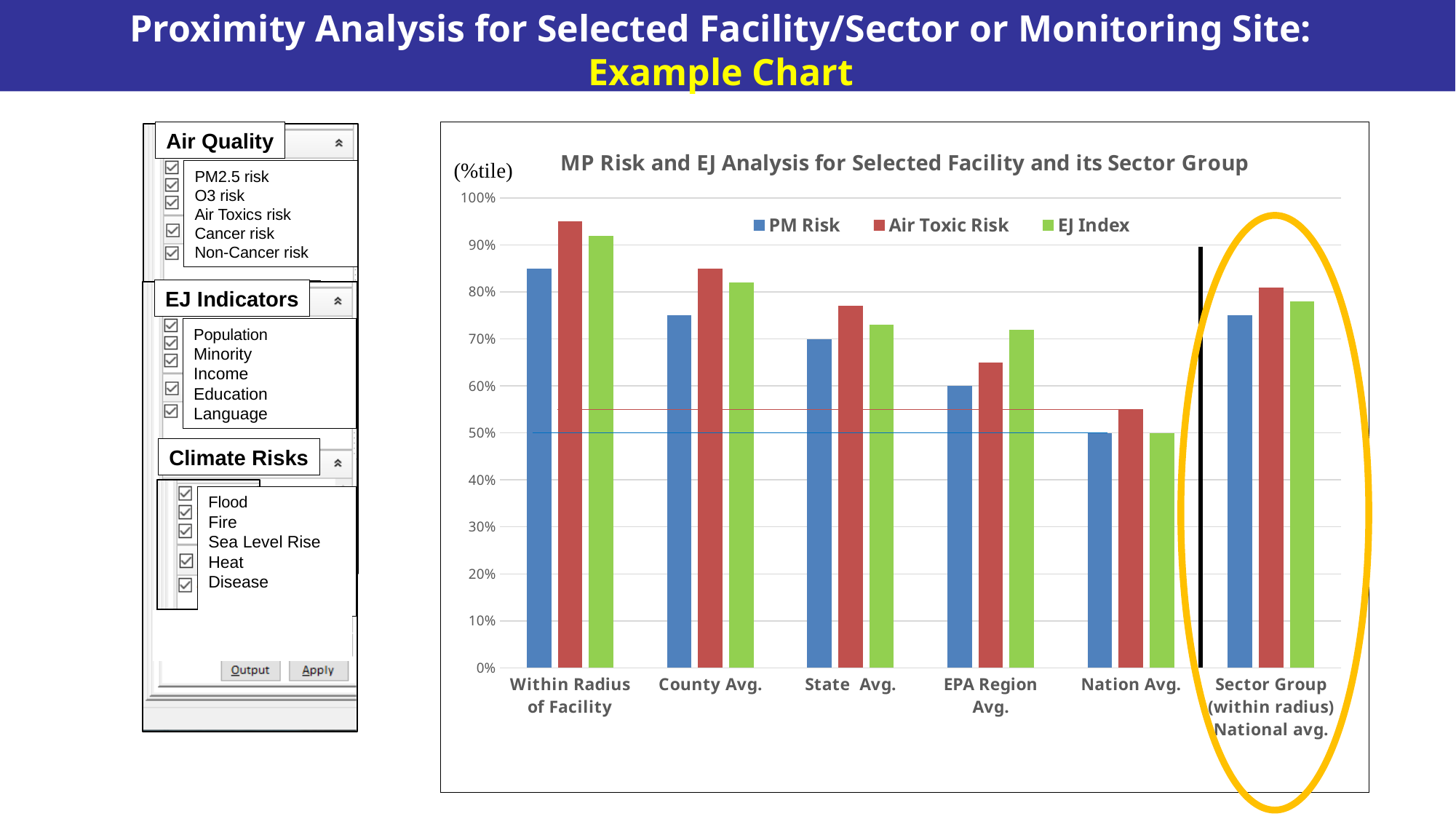
Which category has the lowest PM Risk value? Nation Avg. How many series does the chart legend list? 3 What is the PM Risk value for State Avg.? 70% What is the PM Risk value for Nation Avg.? 50% How many categories are shown along the x axis of the chart? 6 Which is larger, the PM Risk value for Within Radius of Facility or for County Avg.? Within Radius of Facility Which category has the highest Air Toxic Risk value? Within Radius of Facility What type of chart is shown on the slide? bar chart Is the Air Toxic Risk value for Within Radius of Facility greater or less than 90%? greater Is the Air Toxic Risk value for Nation Avg. greater or less than 60%? less What is the PM Risk value for EPA Region Avg.? 60% Does the PM Risk value rise or fall from Within Radius of Facility to Nation Avg.? fall